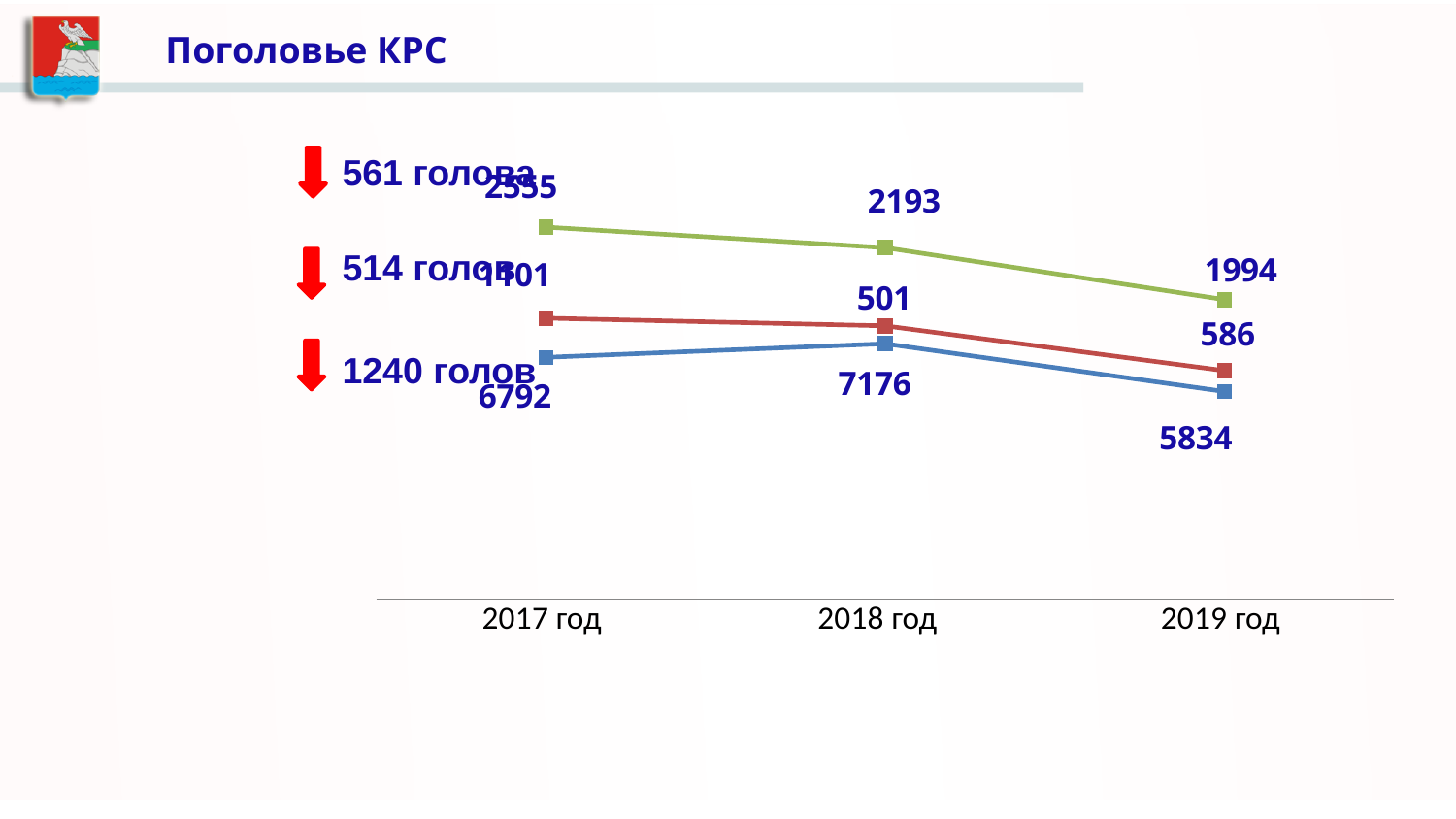
By how much did the blue line's value fall from 2018 год to 2019 год? 1342 What is the value of the blue line for 2019 год? 5834 What is the title of the slide chart? Поголовье КРС What is the value of the green line for 2019 год? 1994 How many years are shown on the x axis of the chart? 3 In which year does the blue line reach its highest value? 2018 год What is the value of the green line for 2018 год? 2193 What is the value of the red line for 2019 год? 586 What is the value of the blue line for 2018 год? 7176 What is the value of the red line for 2018 год? 501 What type of chart is shown on the slide? line chart Does the green line rise or fall from 2017 год to 2019 год? fall